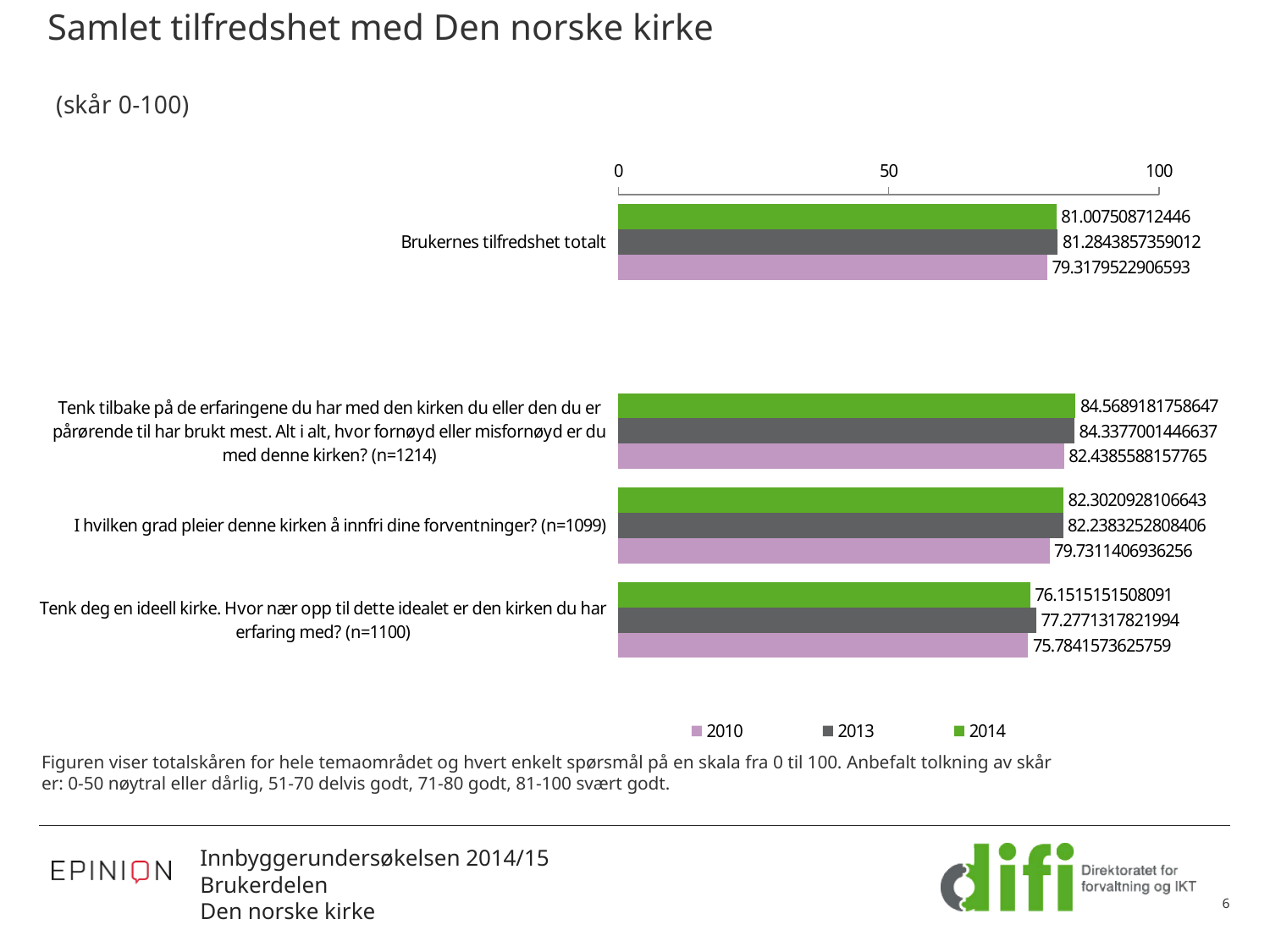
What is the 2013 value for "Tenk deg en ideell kirke. Hvor nær opp til dette idealet er den kirken du har erfaring med? (n=1100)"? 77.2771317821994 What is the 2010 value for "I hvilken grad pleier denne kirken å innfri dine forventninger? (n=1099)"? 79.7311406936256 Which category has the highest 2014 value? Tenk tilbake på de erfaringene du har med den kirken du eller den du er pårørende til har brukt mest. Alt i alt, hvor fornøyd eller misfornøyd er du med denne kirken? (n=1214) Which category has the lowest 2010 value? Tenk deg en ideell kirke. Hvor nær opp til dette idealet er den kirken du har erfaring med? (n=1100) Is the 2010 value for "Tenk deg en ideell kirke" (n=1100) greater or less than 50? greater What is the 2014 value for "Brukernes tilfredshet totalt"? 81.007508712446 What is the difference between the 2013 and 2010 values for "Brukernes tilfredshet totalt"? 1.9664334452419 How many categories are shown in the chart? 4 How many series does the legend list? 3 For "Tenk deg en ideell kirke" (n=1100), which is larger: the 2013 value or the 2014 value? 2013 What kind of chart is shown on the slide? Bar chart Which colour represents the 2014 series in the chart? Green